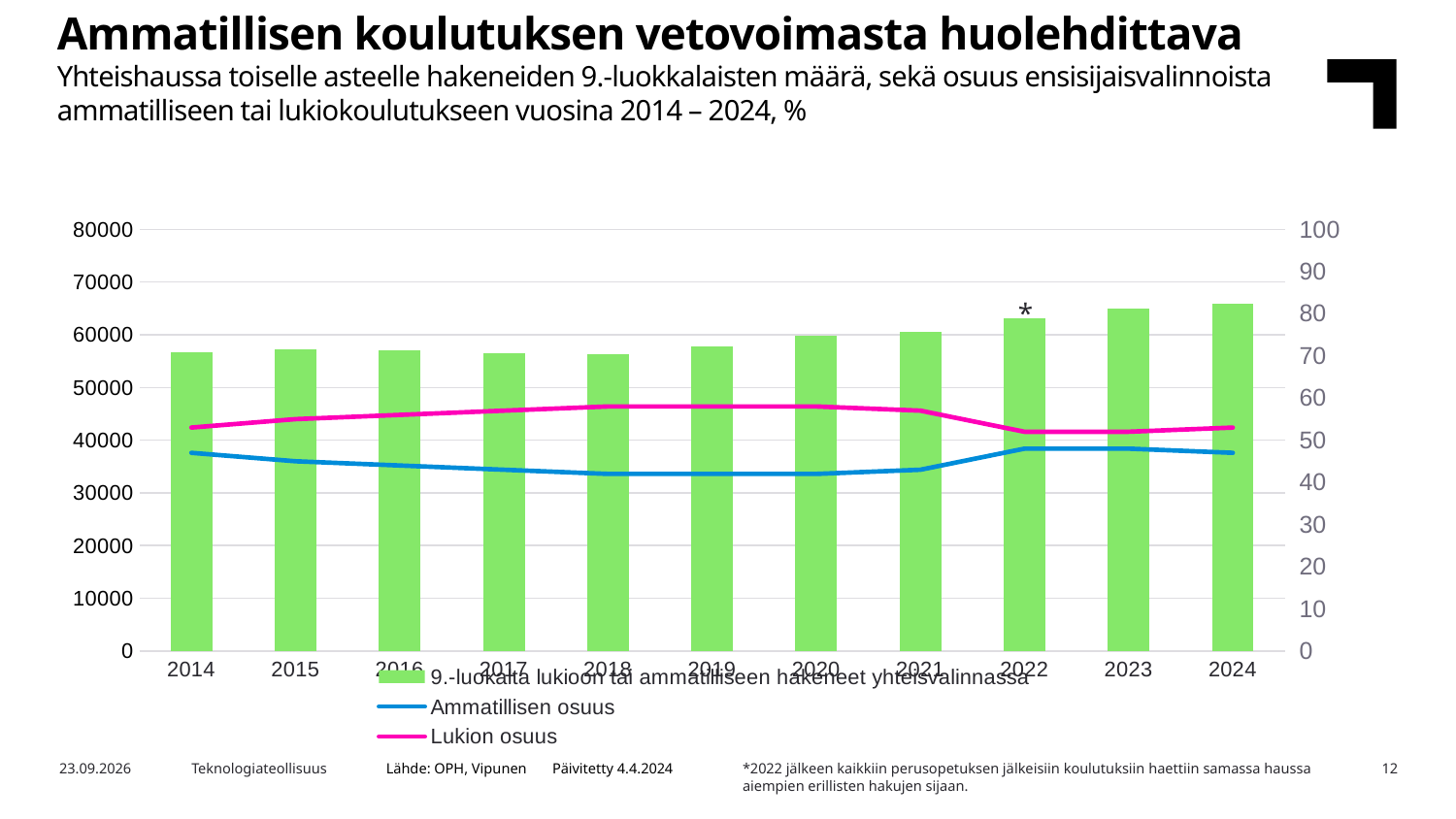
Is the bar value for 2014 greater or less than 60000? less How many series does the chart legend list? 3 How many years are shown on the x axis of the chart? 11 Is the Ammatillisen osuus value for 2019 greater or less than 50 on the right axis? less What kind of chart is shown on the slide? A combined bar and line chart In 2019, which is higher: Ammatillisen osuus or Lukion osuus? Lukion osuus Which year has the tallest bar for 9.-luokalta lukioon tai ammatilliseen hakeneet yhteisvalinnassa? 2024 What colour is the line for Lukion osuus? Pink Which year's bar is marked with an asterisk? 2022 Do the bar values rise or fall from 2020 to 2024? rise Is the Lukion osuus value for 2019 greater or less than 50 on the right axis? greater